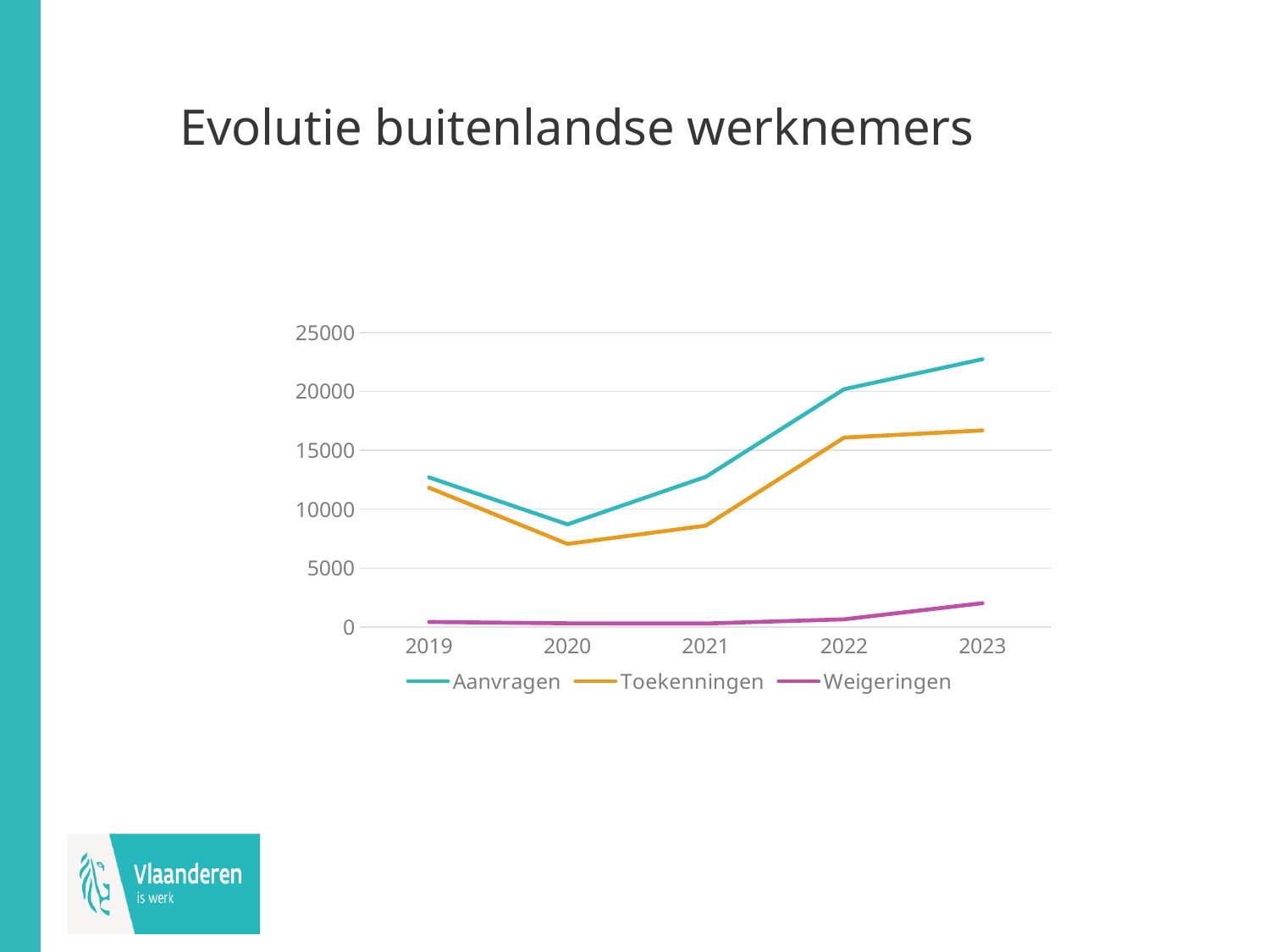
Do the values for Aanvragen rise or fall from 2020 to 2023? Rise What kind of chart is shown on the slide? Line chart In which year is the value for Toekenningen lowest? 2020 How many years are shown on the x axis? 5 Is the value for Toekenningen in 2020 greater or less than 10000? less Is the value for Aanvragen in 2023 greater or less than 20000? greater In which year is the value for Aanvragen lowest? 2020 In which year is the value for Aanvragen highest? 2023 Is the value for Weigeringen in 2023 greater or less than 5000? less How many series does the legend list? 3 Which is larger in 2022, Aanvragen or Toekenningen? Aanvragen What is the title of the slide? Evolutie buitenlandse werknemers